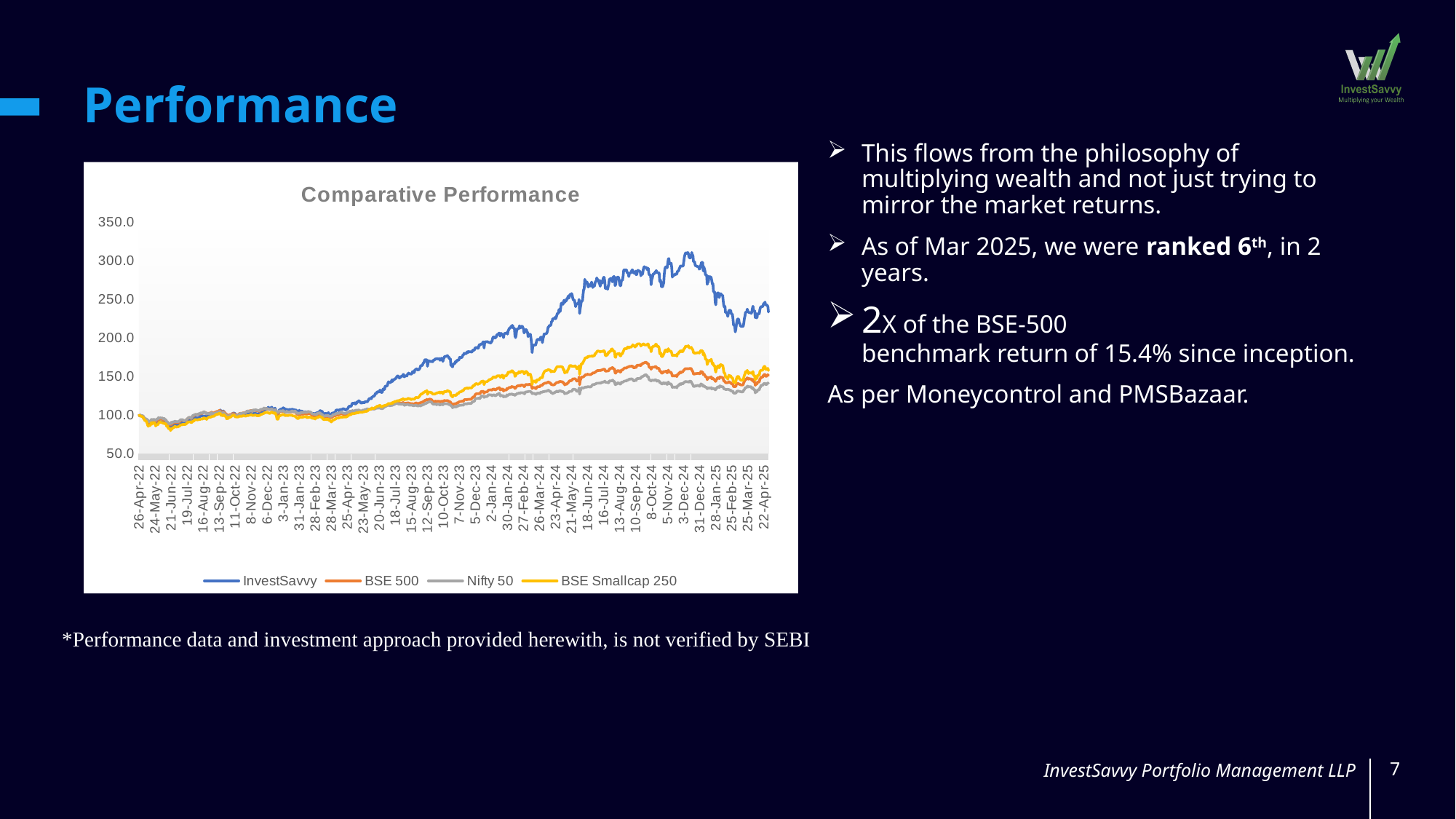
Does the InvestSavvy line overall rise or fall from 26-Apr-22 to 22-Apr-25? rise Which series has the highest value at the end of the Comparative Performance chart (22-Apr-25)? InvestSavvy At 22-Apr-25, which is larger in the Comparative Performance chart: InvestSavvy or BSE 500? InvestSavvy Is the value for InvestSavvy at 22-Apr-25 greater or less than 200? greater Which series has the lowest value at the end of the Comparative Performance chart (22-Apr-25)? Nifty 50 Is the peak value of the InvestSavvy line greater or less than 250? greater Is the value for Nifty 50 at 22-Apr-25 greater or less than 200? less Which colour is used for the InvestSavvy line in the Comparative Performance chart? blue How many series does the legend of the Comparative Performance chart list? 4 What kind of chart is the Comparative Performance chart? line chart What is the title of the chart on the slide? Comparative Performance